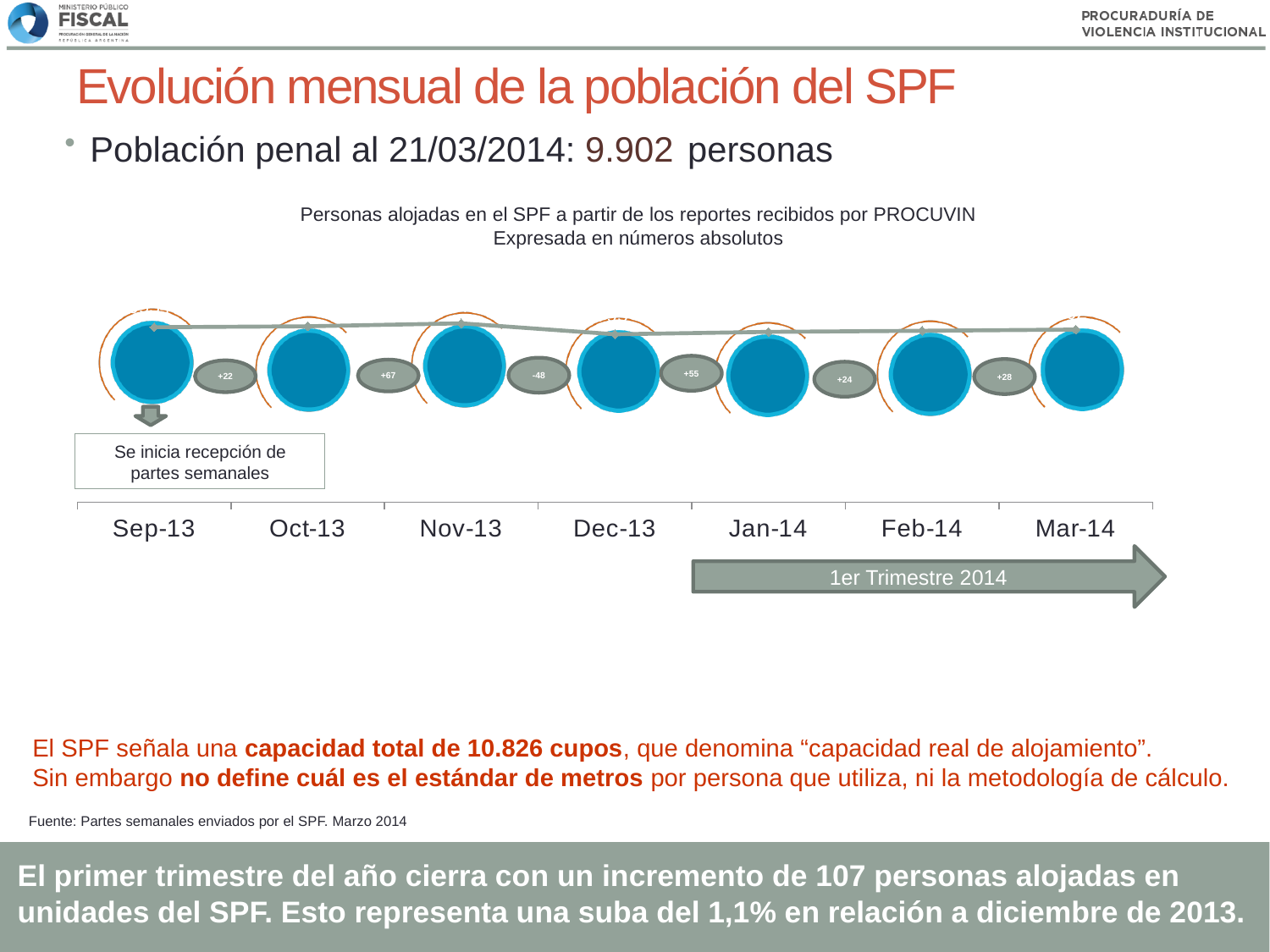
Which month-to-month interval in the chart shows a decrease? Nov-13 to Dec-13 (-48) What change is labelled between Feb-14 and Mar-14 in the chart? +28 What is the first month shown on the x axis of the chart? Sep-13 What change is labelled between Nov-13 and Dec-13 in the chart? -48 What change is labelled between Oct-13 and Nov-13 in the chart? +67 What change is labelled between Sep-13 and Oct-13 in the chart? +22 What change is labelled between Jan-14 and Feb-14 in the chart? +24 Which month-to-month interval shows the largest labelled increase in the chart? Oct-13 to Nov-13 (+67) How many months are shown along the x axis of the chart? 7 What label appears on the arrow beneath the months Jan-14 to Mar-14 in the chart? 1er Trimestre 2014 What change is labelled between Dec-13 and Jan-14 in the chart? +55 Is the labelled change from Dec-13 to Jan-14 larger or smaller than the change from Jan-14 to Feb-14? larger